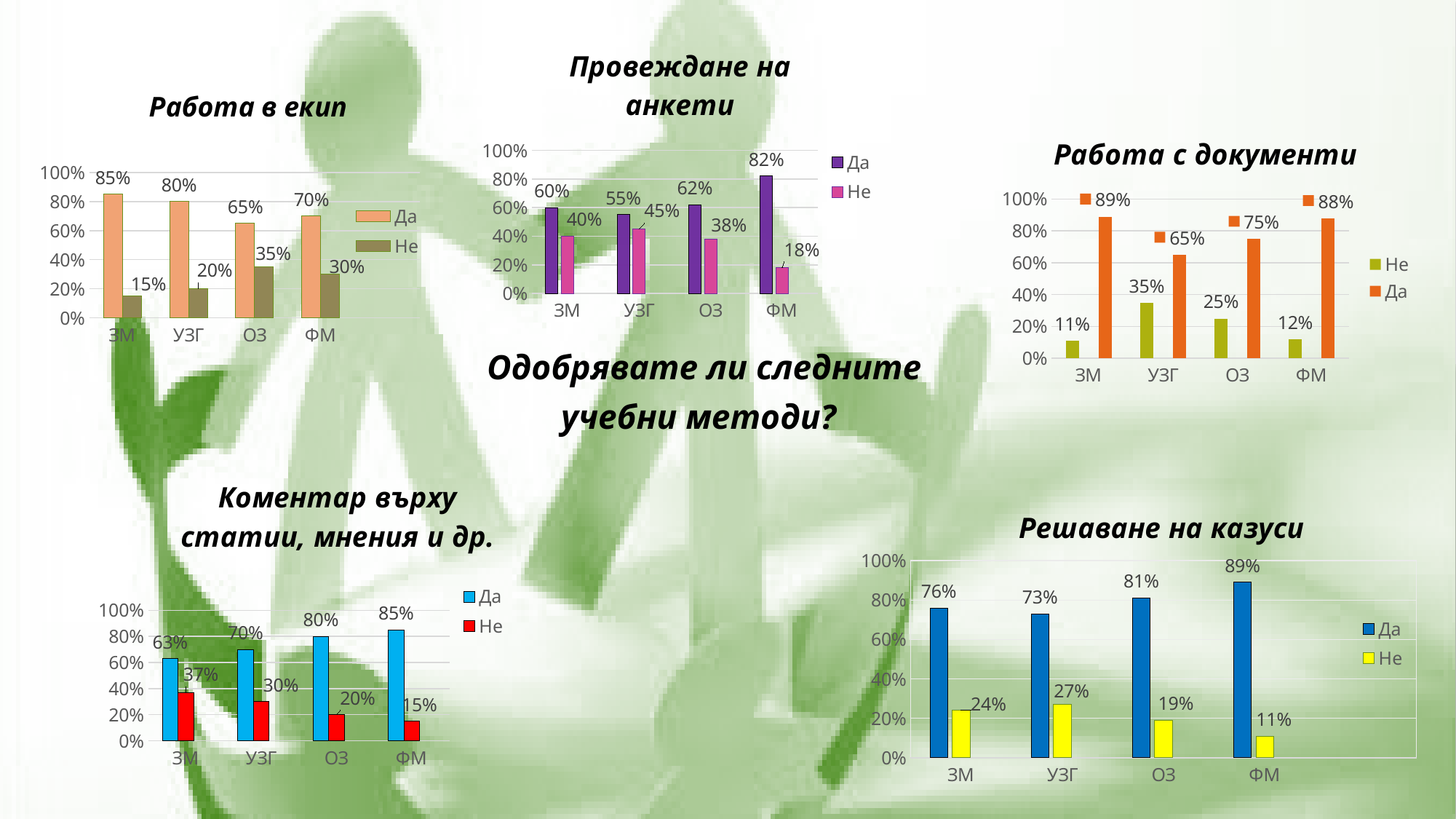
How many series does the legend of the 'Решаване на казуси' chart list? 2 In the 'Провеждане на анкети' chart, what is the 'Не' value for ФМ? 18% What type of chart is 'Работа с документи'? Bar chart In the 'Коментар върху статии, мнения и др.' chart, is the 'Да' value for ЗМ or for ФМ larger? ФМ In the 'Коментар върху статии, мнения и др.' chart, what is the 'Да' value for ОЗ? 80% In the 'Решаване на казуси' chart, how many categories are shown on the x axis? 4 In the 'Решаване на казуси' chart, what is the 'Не' value for УЗГ? 27% In the 'Работа с документи' chart, which category has the lowest 'Да' value? УЗГ In the 'Провеждане на анкети' chart, what is the difference between the 'Да' values for ФМ and УЗГ? 27% In the 'Работа в екип' chart, which category has the highest 'Не' value? ОЗ In the 'Работа в екип' chart, what is the 'Да' value for ЗМ? 85% In the 'Работа с документи' chart, what is the 'Не' value for УЗГ? 35%